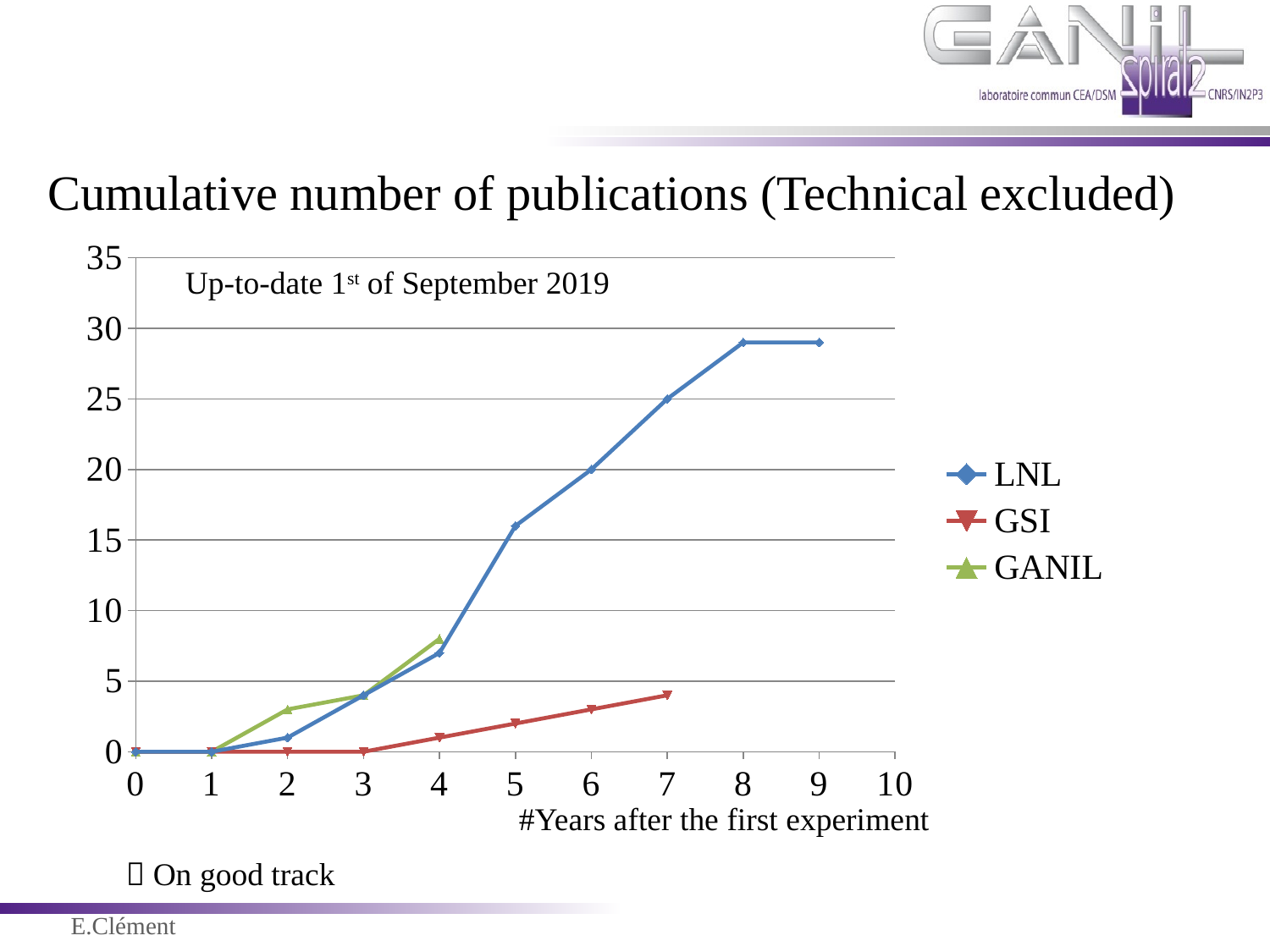
What kind of chart is shown on the slide? line chart Is the LNL value at year 8 greater or less than 25? greater Is the GANIL value at year 4 greater or less than 10? less Which series reaches the highest cumulative number of publications? LNL What is the GSI value at 3 years after the first experiment? 0 Does the LNL series rise or fall as the number of years after the first experiment increases? rise Is the GSI value at year 7 greater or less than 5? less Which series has the lowest cumulative number of publications at year 7? GSI What is the LNL value at 7 years after the first experiment? 25 What is the LNL value at 6 years after the first experiment? 20 How many series does the legend list? 3 What is the label of the x axis? #Years after the first experiment